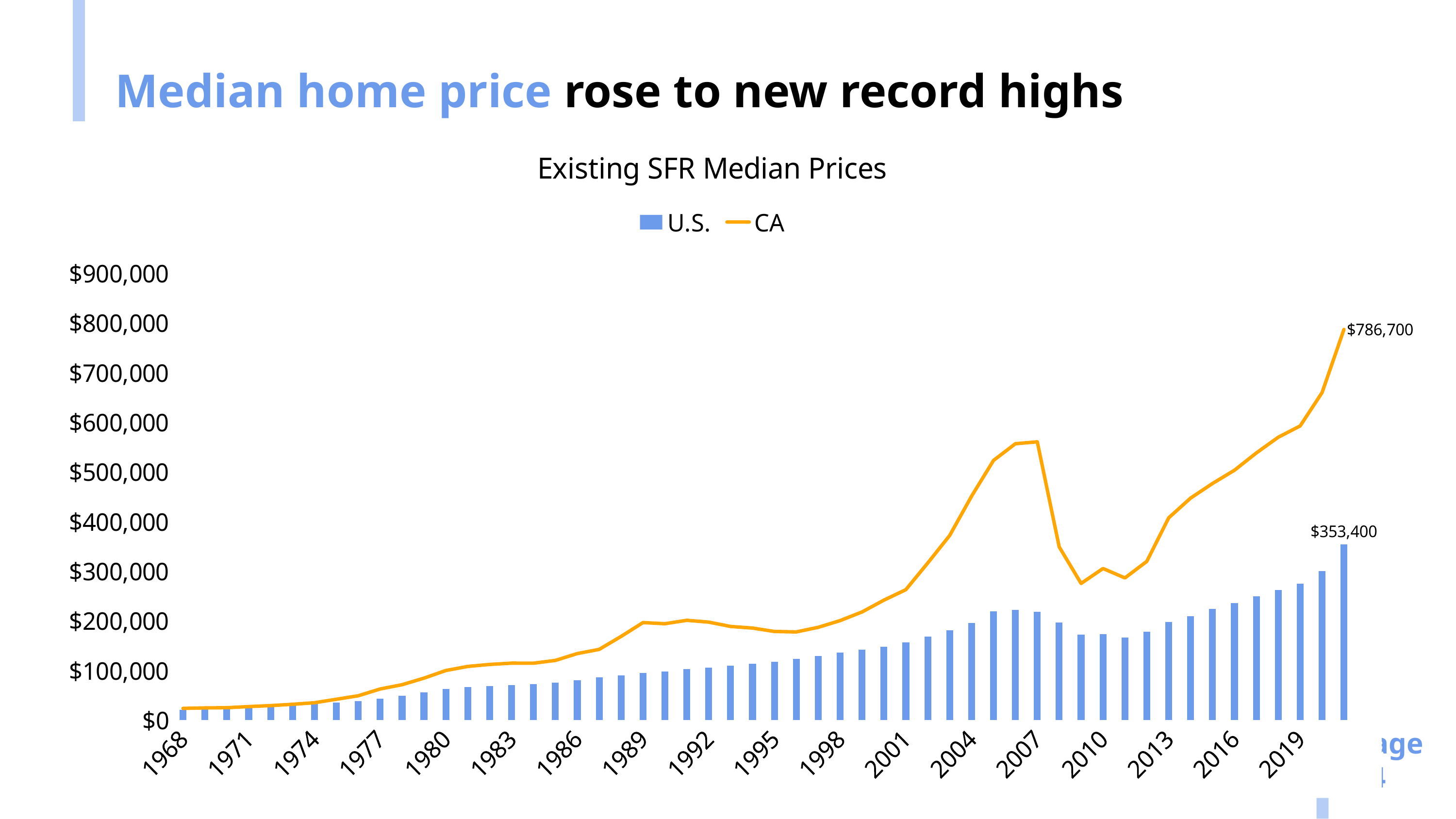
What kind of chart is shown on the slide? A combined bar and line chart How many series does the legend list? 2 At the final data point, which is larger, the CA value or the U.S. value? CA Is the CA value in 2007 greater or less than $500,000? greater Is the CA value in 2010 greater or less than $400,000? less Do the U.S. bars generally rise or fall from 1968 to the final year? rise What is the labelled value of the final U.S. bar? $353,400 What colour is the CA line? Orange What is the labelled value of the CA line at its final point? $786,700 What is the title of the chart? Existing SFR Median Prices What is the difference between the final labelled CA value and the final labelled U.S. value? $433,300 Is the U.S. value in 1968 greater or less than $100,000? less